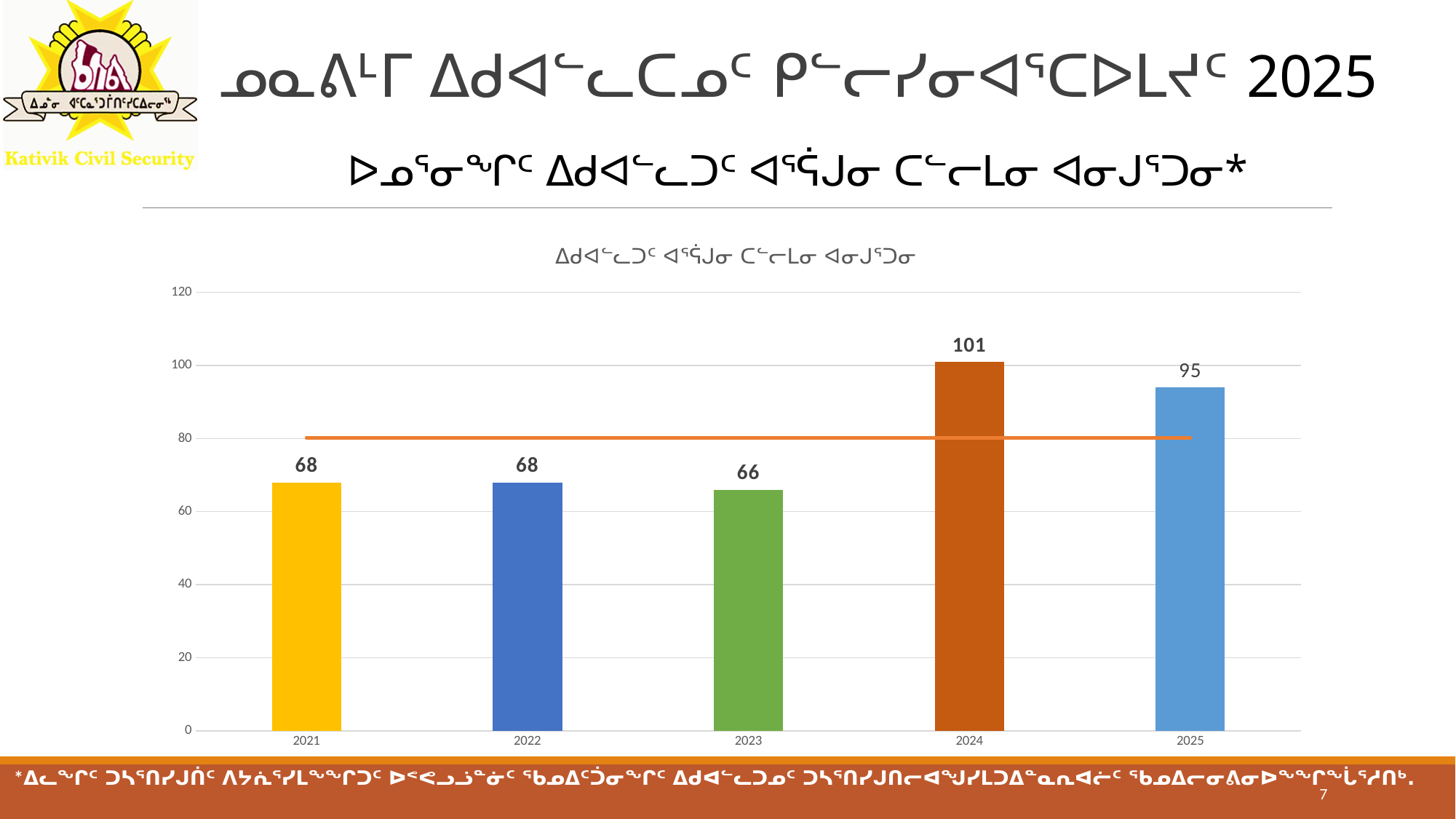
What is the value for 2023? 66 How many years are shown on the x axis? 5 What kind of chart is shown on the slide? bar chart with a line (combination bar and line chart) What is the value for 2024? 101 What is the difference between the values for 2024 and 2025? 6 What is the difference between the values for 2024 and 2023? 35 What colour is the bar for 2024? orange Which year has the highest value? 2024 Which year has the lowest value? 2023 What is the value for 2025? 95 Is the value for 2022 greater or less than 80? less Which is larger, the value for 2021 or the value for 2025? 2025